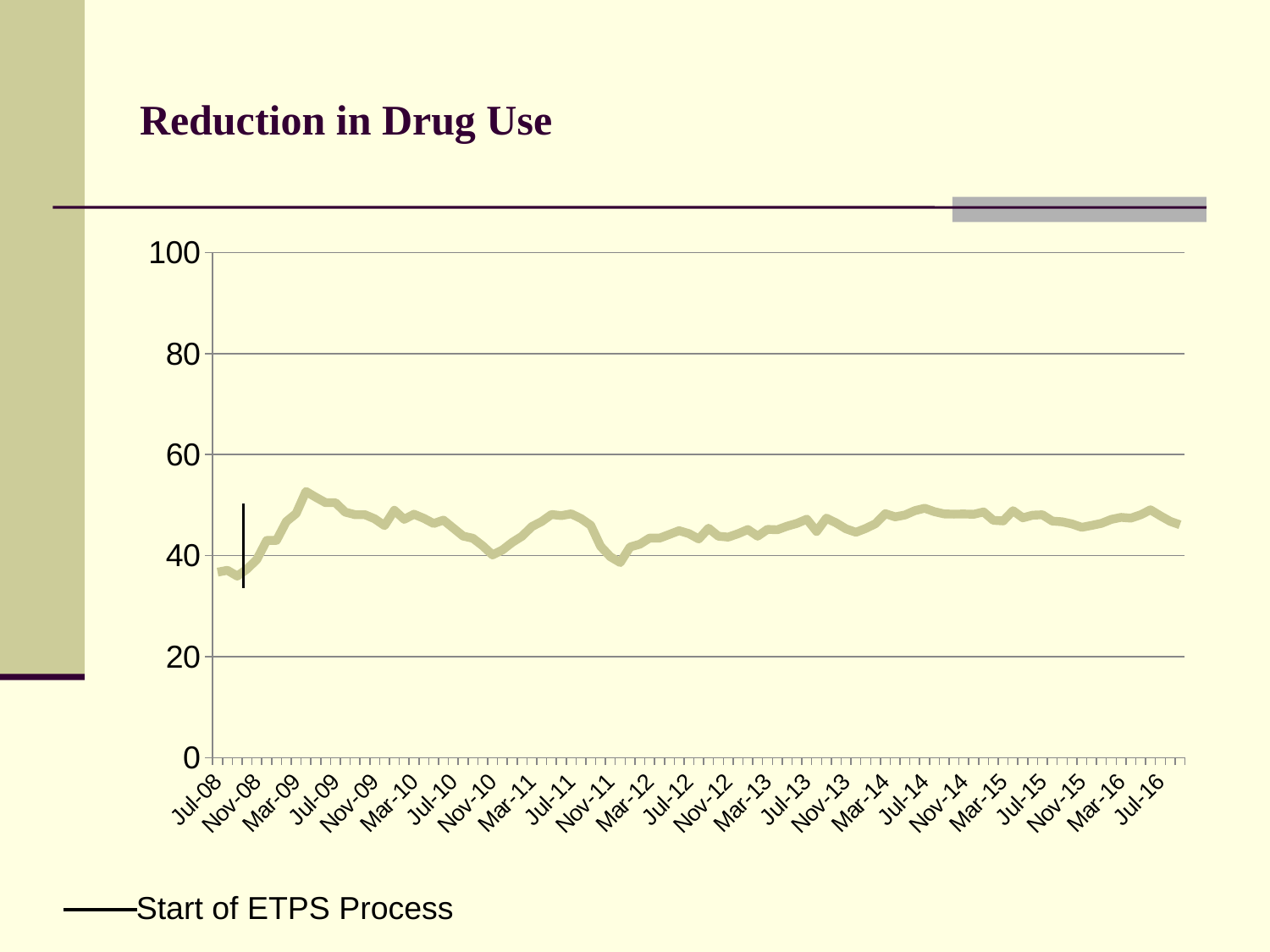
What kind of chart is shown on the slide? line chart What does the legend entry below the chart say? Start of ETPS Process Which is larger, the value for Jul-09 or the value for Nov-11? Jul-09 Is the value for Jul-16 greater or less than 60? less Does the line rise or fall between Jul-09 and Nov-10? fall What is the highest value shown on the vertical axis? 100 Which is larger, the value for Jul-08 or the value for Jul-16? Jul-16 Is the value for Jul-16 greater or less than 40? greater Does the line rise or fall between Jul-08 and Mar-09? rise Is the value for Jul-08 greater or less than 40? less What is the title of the chart on the slide? Reduction in Drug Use